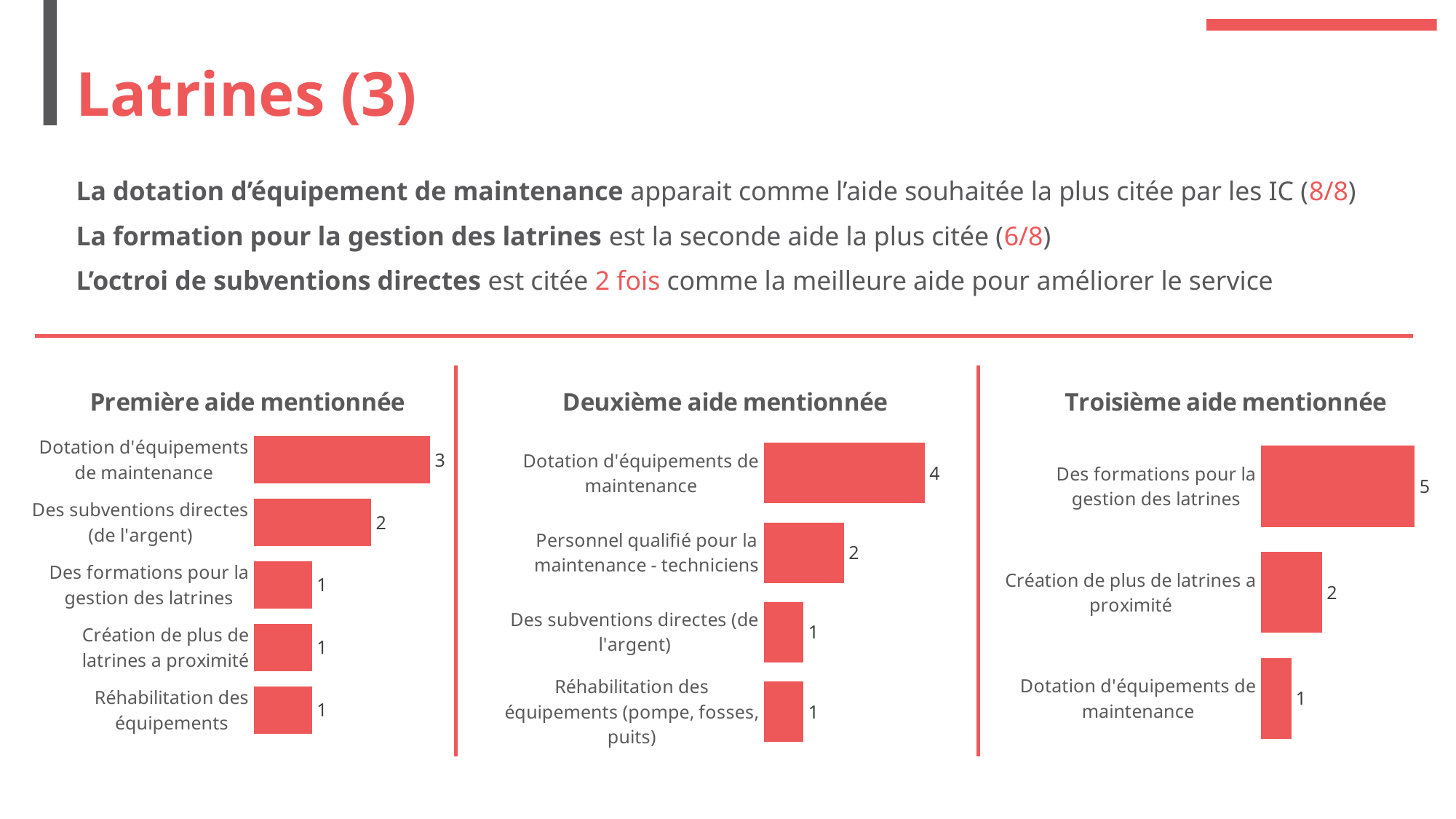
In the 'Troisième aide mentionnée' chart, which is larger: 'Création de plus de latrines a proximité' or 'Dotation d'équipements de maintenance'? Création de plus de latrines a proximité In the 'Troisième aide mentionnée' chart, what is the value for 'Des formations pour la gestion des latrines'? 5 In the 'Deuxième aide mentionnée' chart, what is the value for 'Personnel qualifié pour la maintenance - techniciens'? 2 In the 'Première aide mentionnée' chart, what is the difference between 'Dotation d'équipements de maintenance' and 'Des subventions directes (de l'argent)'? 1 In the 'Deuxième aide mentionnée' chart, which category has the highest value? Dotation d'équipements de maintenance In the 'Première aide mentionnée' chart, which category has the highest value? Dotation d'équipements de maintenance In the 'Troisième aide mentionnée' chart, which category has the lowest value? Dotation d'équipements de maintenance In the 'Première aide mentionnée' chart, how many categories are shown? 5 What type of chart is the 'Deuxième aide mentionnée' chart? Bar chart In the 'Première aide mentionnée' chart, what is the value for 'Dotation d'équipements de maintenance'? 3 In the 'Deuxième aide mentionnée' chart, how many categories are shown? 4 In the 'Troisième aide mentionnée' chart, what is the difference between 'Des formations pour la gestion des latrines' and 'Création de plus de latrines a proximité'? 3